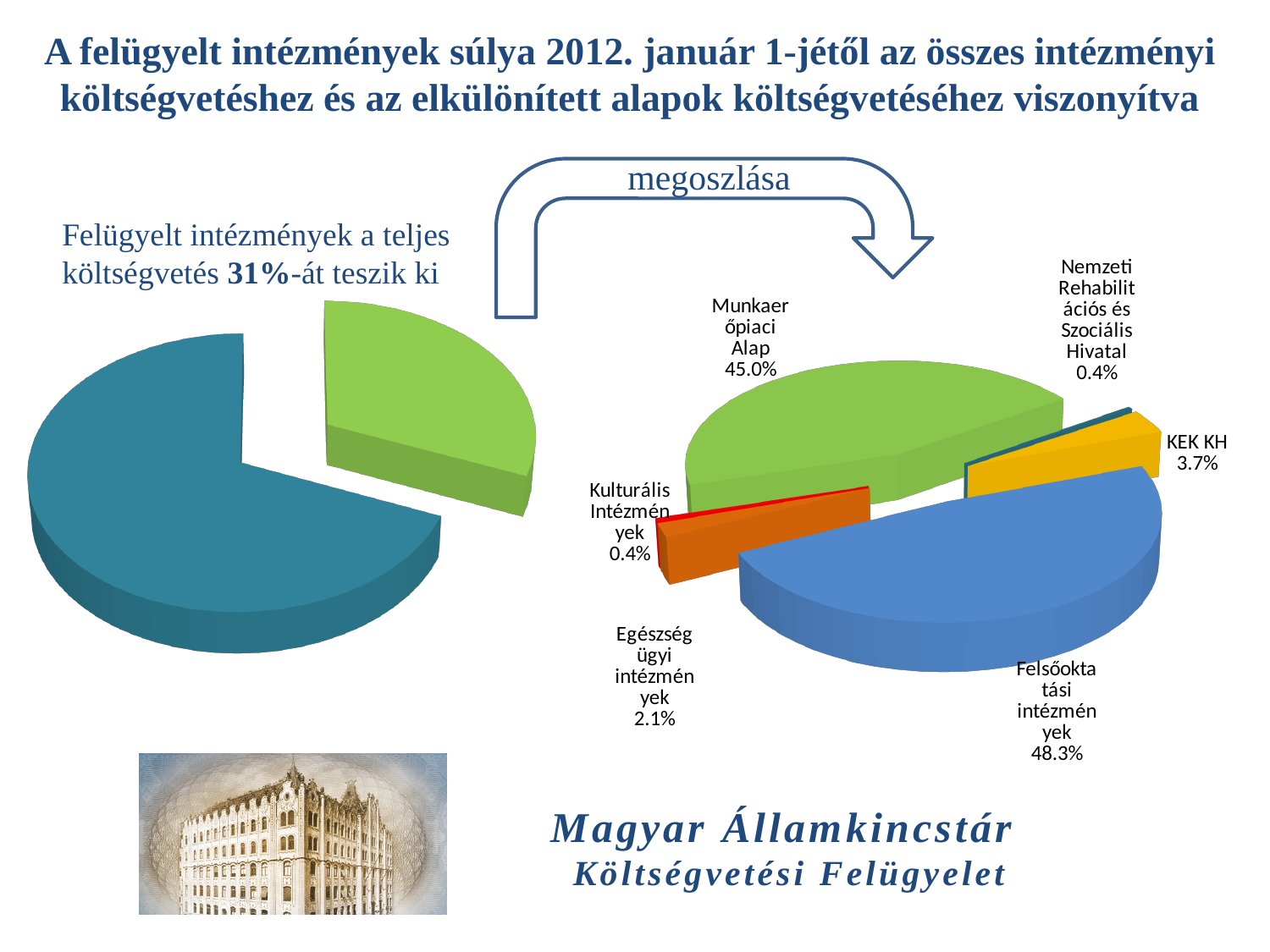
On the right pie chart, what is the difference in percentage points between KEK KH and Egészségügyi intézmények? 1.6 percentage points How many slices does the right pie chart have? 6 How many slices does the left pie chart have? 2 On the right pie chart, which is larger: the share for KEK KH or the share for Egészségügyi intézmények? KEK KH On the right pie chart, what share is shown for Nemzeti Rehabilitációs és Szociális Hivatal? 0.4% On the right pie chart, what share is shown for Felsőoktatási intézmények? 48.3% On the right pie chart, what share is shown for KEK KH? 3.7% On the right pie chart, what share is shown for Egészségügyi intézmények? 2.1% What kind of chart is the chart on the left of the slide? Pie chart On the right pie chart, what share is shown for Munkaerőpiaci Alap? 45.0% On the right pie chart, what is the difference in percentage points between Felsőoktatási intézmények and Munkaerőpiaci Alap? 3.3 percentage points On the right pie chart, which category has the largest share? Felsőoktatási intézmények